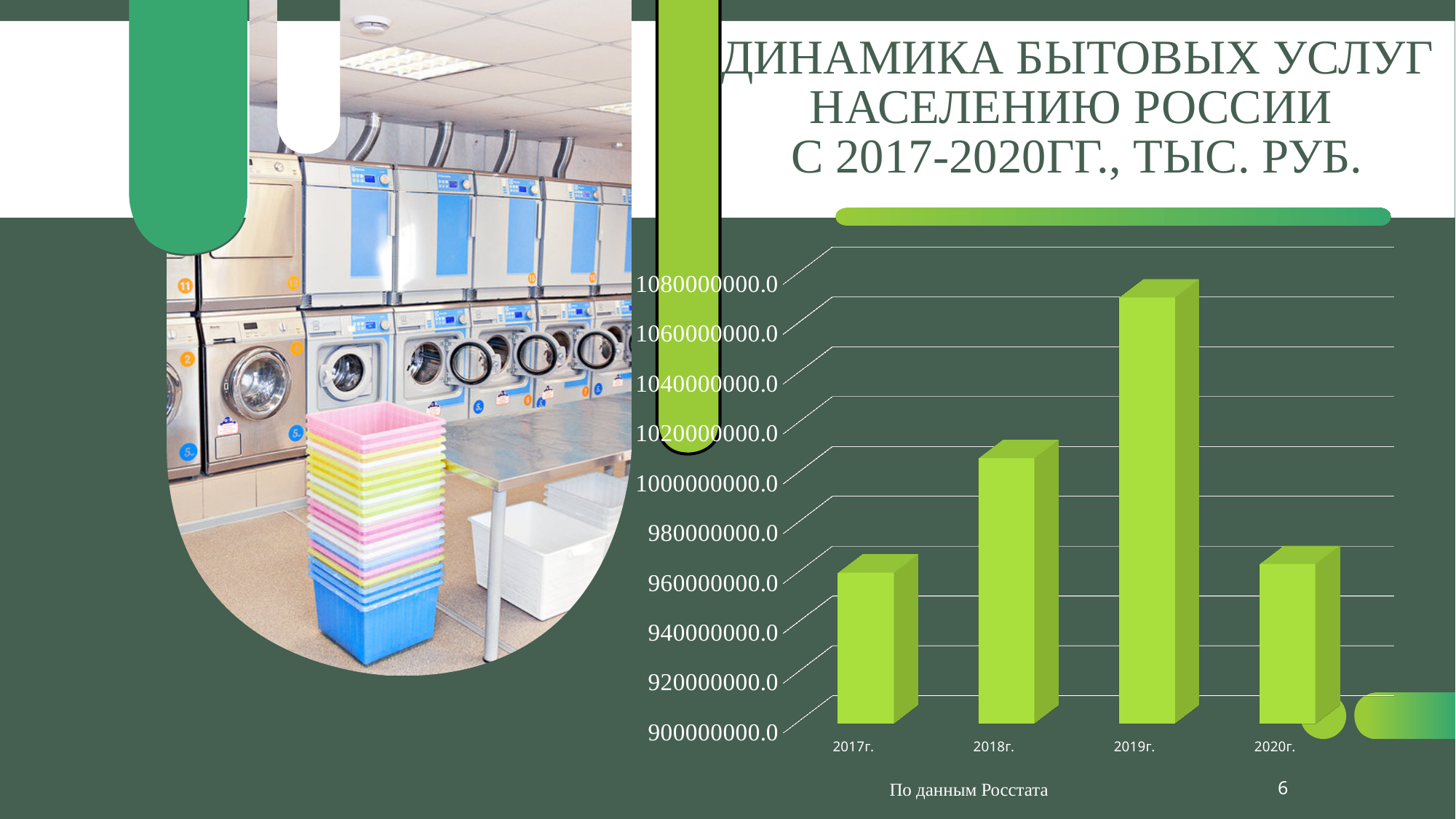
Is the value for 2017г. greater or less than 980000000.0? less Which is larger, the value for 2018г. or the value for 2019г.? 2019г. Is the value for 2019г. greater or less than 1040000000.0? greater How many years (categories) are plotted on the chart? 4 How do the values change from 2017г. to 2020г.? rise from 2017 to 2019, then fall in 2020 Which year has the lowest bar on the chart? 2017г. According to the note under the chart, what is the data source? По данным Росстата Which is larger, the value for 2017г. or the value for 2020г.? 2020г. Is the value for 2018г. greater or less than 980000000.0? greater What kind of chart is shown on the slide? bar chart Which year has the highest bar on the chart? 2019г.